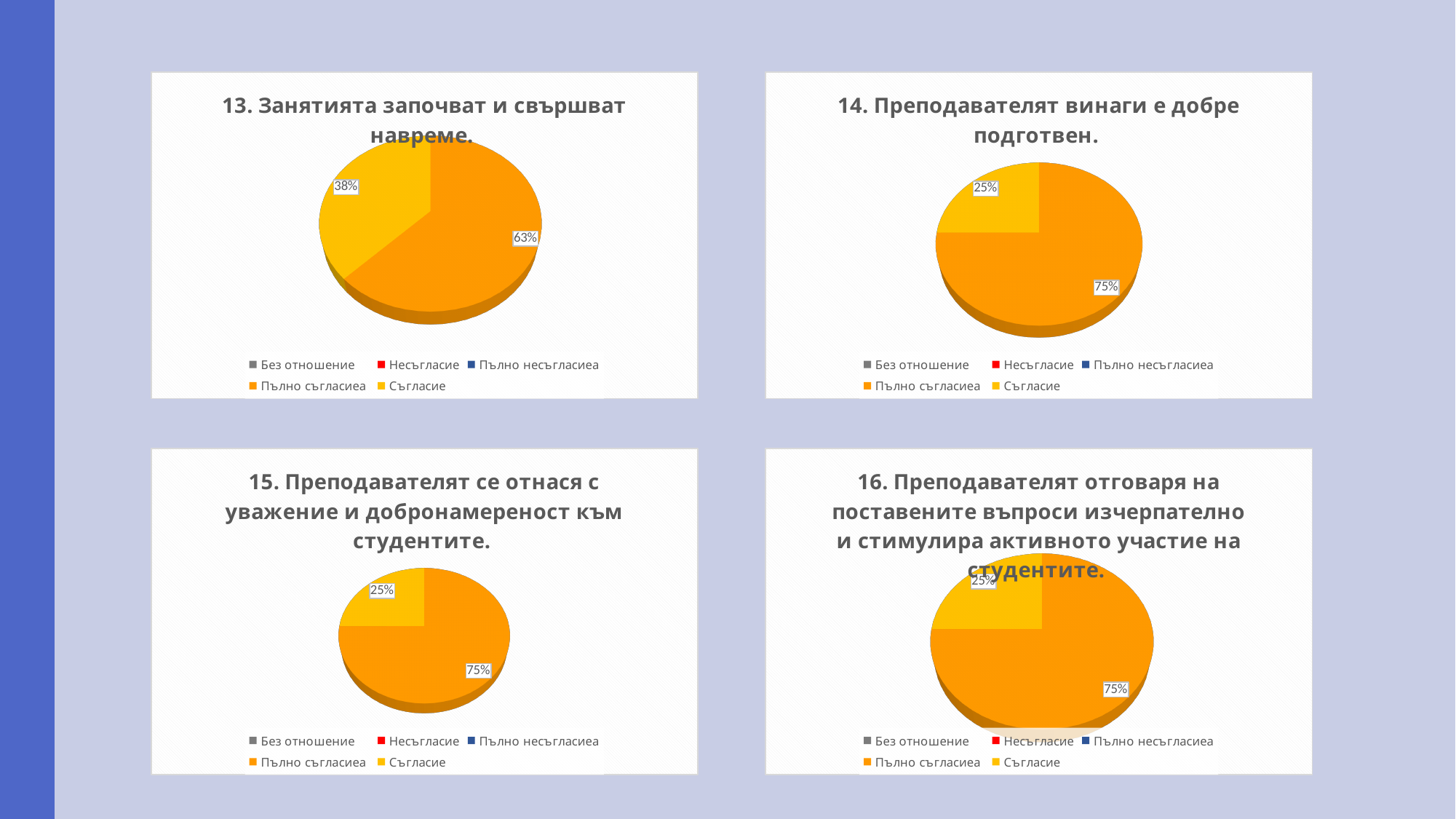
In the chart titled "14. Преподавателят винаги е добре подготвен.", what share is labelled for the "Съгласие" slice? 25% In the chart titled "13. Занятията започват и свършват навреме.", what is the difference between the "Пълно съгласиеа" and "Съгласие" shares? 25% In the chart titled "14. Преподавателят винаги е добре подготвен.", what share is labelled for the "Пълно съгласиеа" slice? 75% In the chart titled "15. Преподавателят се отнася с уважение и добронамереност към студентите.", which slice is the largest? Пълно съгласиеа How many entries does the legend of the chart titled "16. Преподавателят отговаря на поставените въпроси изчерпателно и стимулира активното участие на студентите." list? 5 In the chart titled "13. Занятията започват и свършват навреме.", what colour is the "Съгласие" slice? Yellow In the chart titled "13. Занятията започват и свършват навреме.", what share is labelled for the "Пълно съгласиеа" slice? 63% In the chart titled "15. Преподавателят се отнася с уважение и добронамереност към студентите.", what is the difference between the "Пълно съгласиеа" and "Съгласие" shares? 50% In the chart titled "14. Преподавателят винаги е добре подготвен.", which is larger, the "Пълно съгласиеа" slice or the "Съгласие" slice? Пълно съгласиеа What kind of chart is the top-left chart on the slide? Pie chart